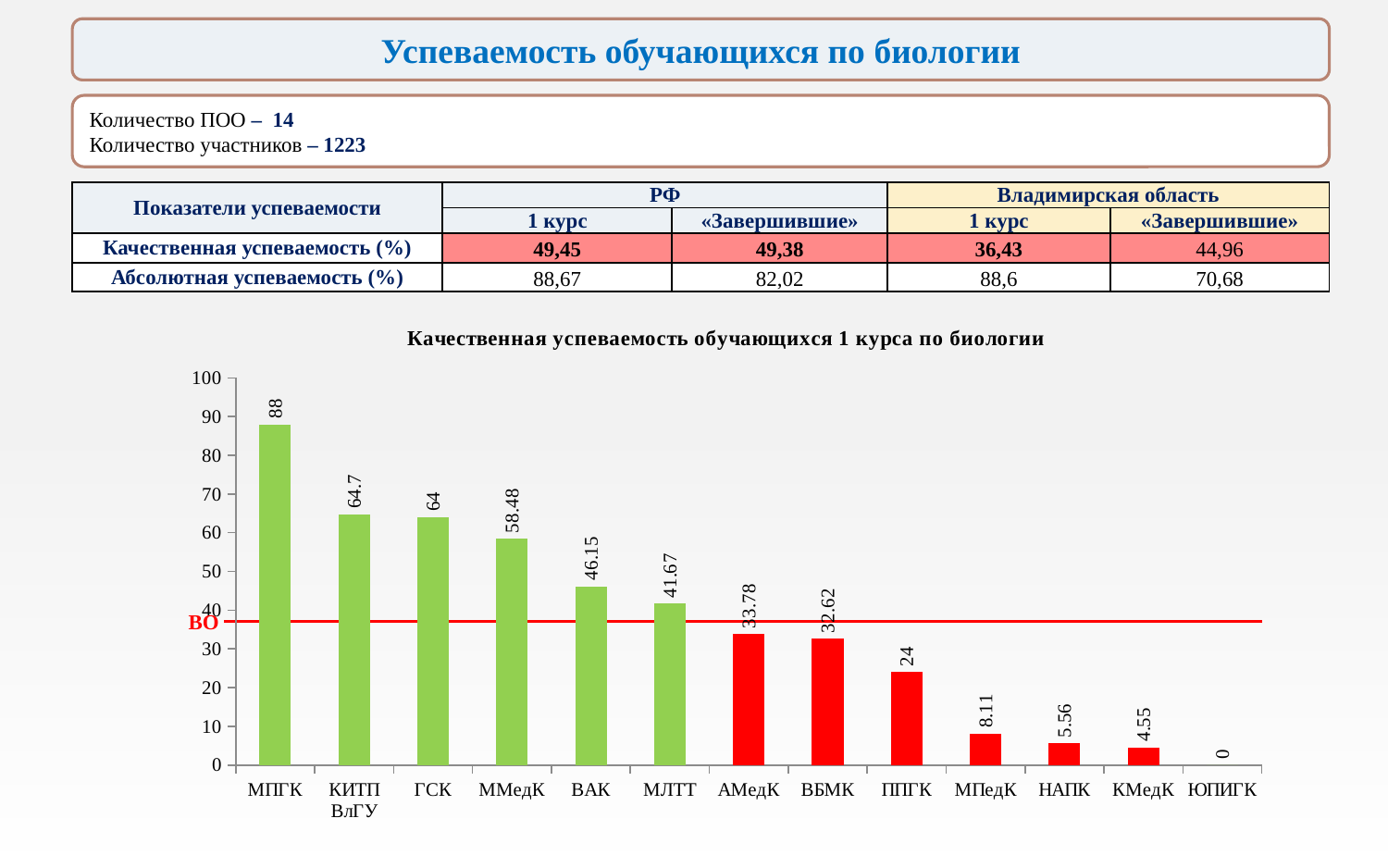
Which is larger, the value for ВАК or the value for МЛТТ? ВАК What kind of chart is shown on the slide? bar chart What is the value for ВБМК in the chart? 32.62 What is the value for МПГК in the chart? 88 What is the value for НАПК in the chart? 5.56 Which category has the lowest value in the chart? ЮПИГК What is the label on the horizontal red line drawn across the chart? ВО Is the value for ППГК greater or less than 30? less Which category has the highest value in the chart? МПГК How many categories are shown on the x axis of the chart? 13 What is the value for ММедК in the chart? 58.48 What is the difference between the values for МПГК and ГСК? 24